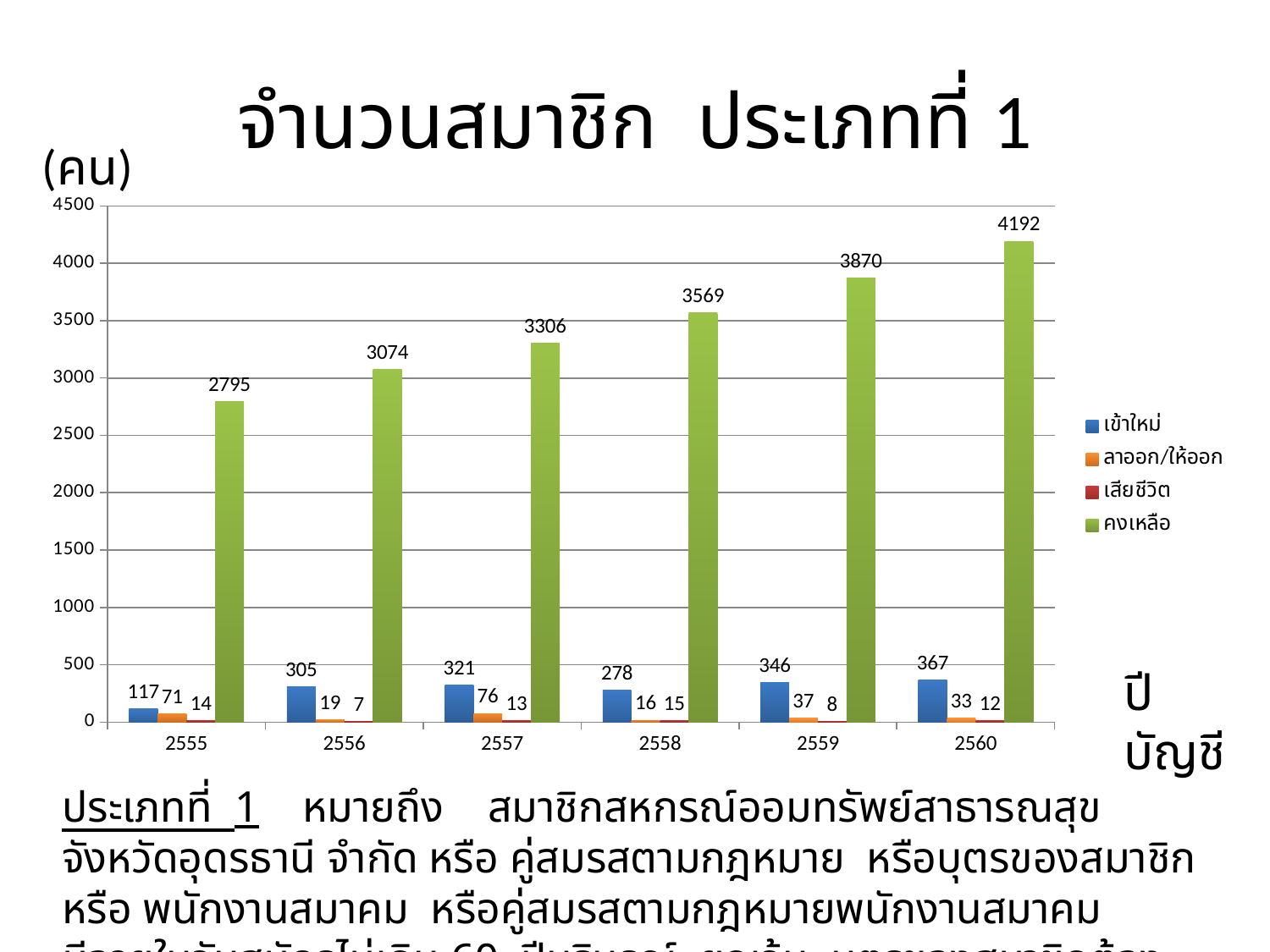
What is the value of เข้าใหม่ for 2557? 321 What kind of chart is shown on the slide? bar chart What is the value of เสียชีวิต for 2558? 15 In which year is เข้าใหม่ the lowest? 2555 In which year is คงเหลือ the highest? 2560 Does คงเหลือ rise or fall from 2555 to 2560? rise What is the value of คงเหลือ for 2560? 4192 What is the difference between คงเหลือ in 2560 and คงเหลือ in 2559? 322 How many series does the legend list? 4 What is the value of ลาออก/ให้ออก for 2555? 71 Which is larger: เข้าใหม่ in 2556 or เข้าใหม่ in 2558? 2556 How many years are shown on the x axis? 6